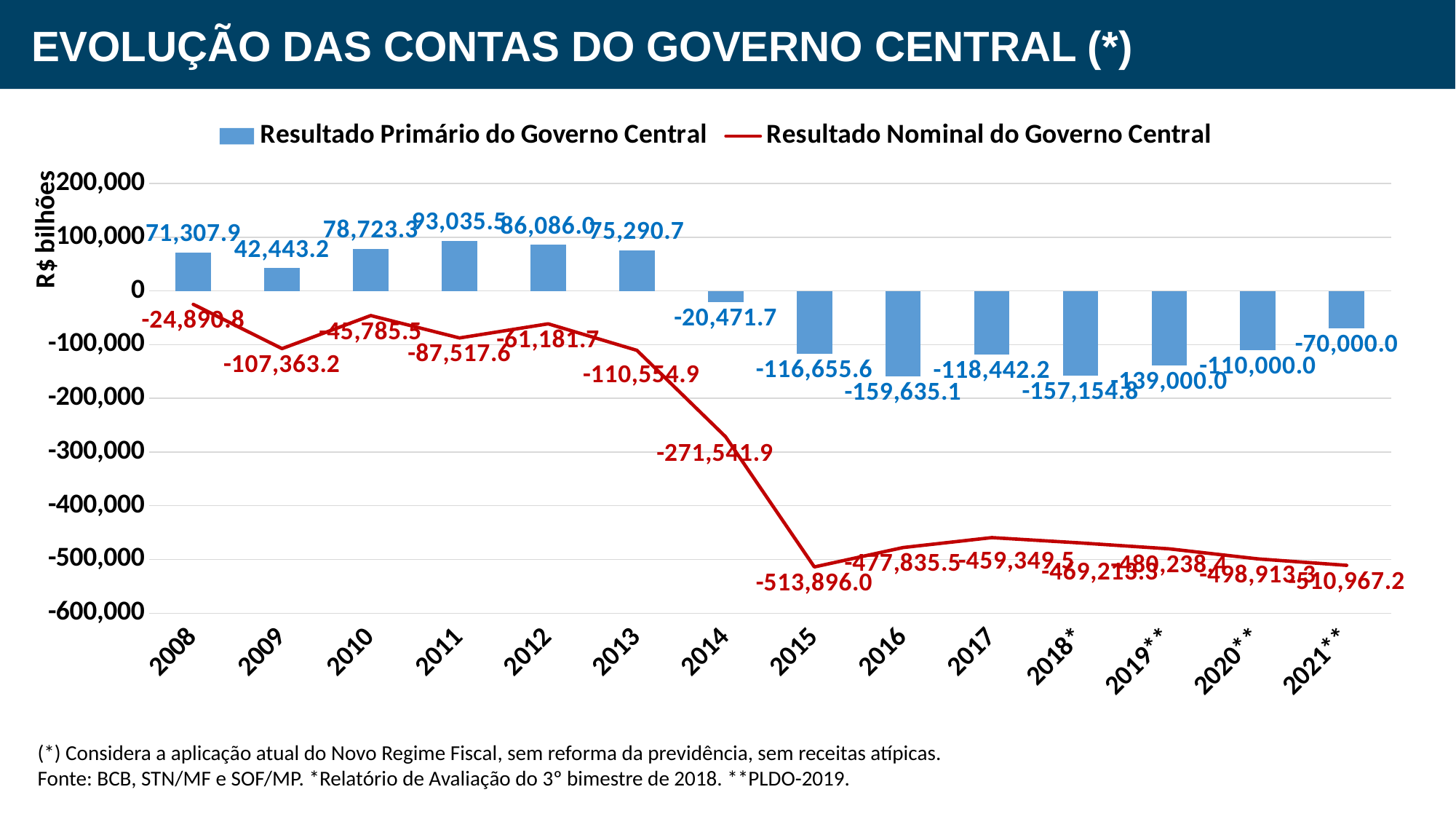
What kind of chart is shown on the slide? A combined bar and line chart What is the value of Resultado Primário do Governo Central for 2011? 93,035.5 What is the value of Resultado Primário do Governo Central for 2021**? -70,000.0 How many years are shown on the x axis? 14 Does Resultado Nominal do Governo Central rise or fall from 2013 to 2015? fall In which year is Resultado Primário do Governo Central highest? 2011 Which year has the larger Resultado Primário do Governo Central, 2010 or 2013? 2010 What is the value of Resultado Nominal do Governo Central for 2015? -513,896.0 How many series does the legend list? 2 In which year is Resultado Nominal do Governo Central highest? 2008 Is the value of Resultado Primário do Governo Central for 2016 greater or less than -100,000? less What is the difference between Resultado Primário do Governo Central in 2008 and 2009? 28,864.7